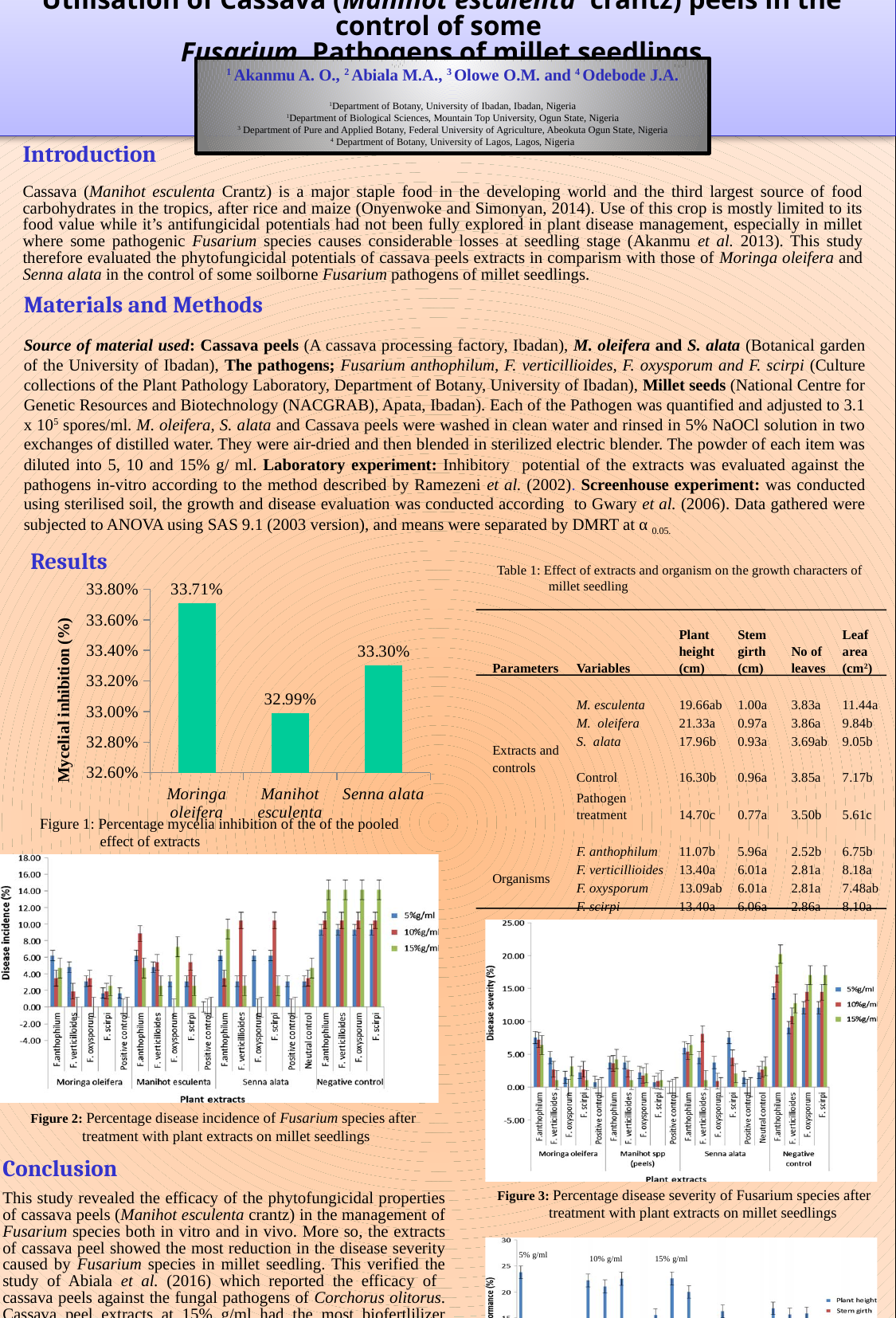
In Figure 1, what is the mycelial inhibition value for Manihot esculenta? 32.99% In Figure 1, which has a higher mycelial inhibition, Senna alata or Manihot esculenta? Senna alata In Figure 1, what is the mycelial inhibition value for Moringa oleifera? 33.71% In Figure 1, what is the difference in mycelial inhibition between Moringa oleifera and Manihot esculenta? 0.72% In Figure 3, is the disease severity for F. anthophilum at 15%g/ml under Negative control greater or less than 15.00? greater In Figure 2, how many series does the legend list? 3 What kind of chart is Figure 1? Bar chart In Figure 2, is the disease incidence for F. anthophilum at 15%g/ml under Negative control greater or less than 12.00? greater In Figure 1, how many extracts are plotted? 3 In Figure 1, which extract has the highest mycelial inhibition? Moringa oleifera In Figure 1, what is the mycelial inhibition value for Senna alata? 33.30% In Figure 1, which extract has the lowest mycelial inhibition? Manihot esculenta